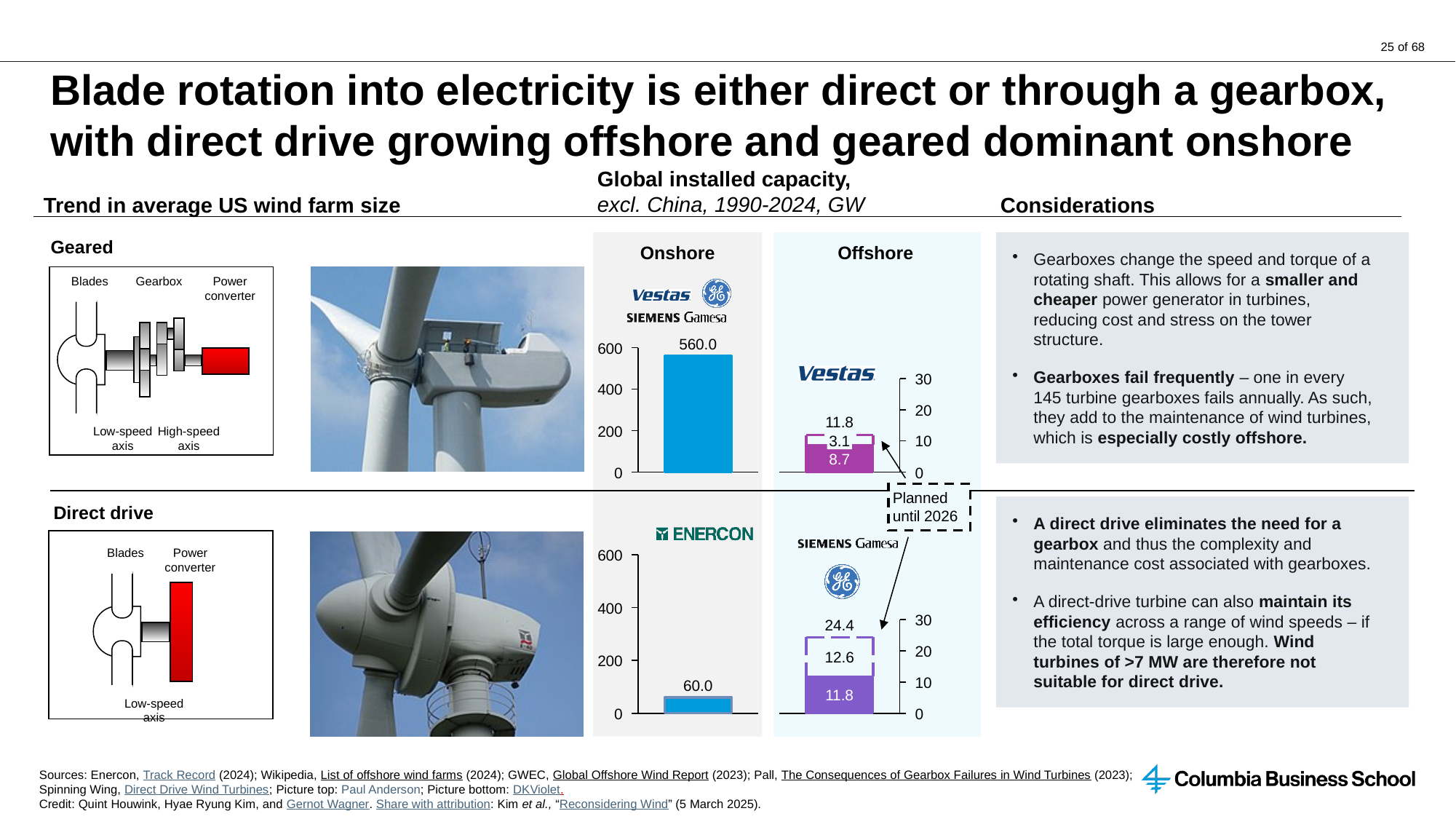
In the Offshore direct drive chart, what is the total value labelled at the top of the stacked bar? 24.4 In the Offshore geared chart, what is the planned-until-2026 (dashed) portion of the bar? 3.1 In the Onshore direct drive chart, what is the global installed capacity shown for direct-drive onshore turbines? 60.0 In the Offshore direct drive chart, what is the planned-until-2026 (dashed) portion of the bar? 12.6 In the Offshore geared chart, what is the total value labelled at the top of the stacked bar? 11.8 What type of chart is used to show the global installed capacity figures? Bar chart In the Offshore direct drive chart, what is the installed (solid) portion of the bar? 11.8 What unit is the global installed capacity chart measured in, according to its title? GW In the Offshore geared chart, what is the installed (solid) portion of the bar? 8.7 What is the difference between the onshore geared capacity (560.0) and the onshore direct drive capacity (60.0)? 500.0 In the Onshore geared chart, what is the global installed capacity shown for geared onshore turbines? 560.0 Which is larger: the offshore direct drive total (24.4) or the offshore geared total (11.8)? Offshore direct drive (24.4)